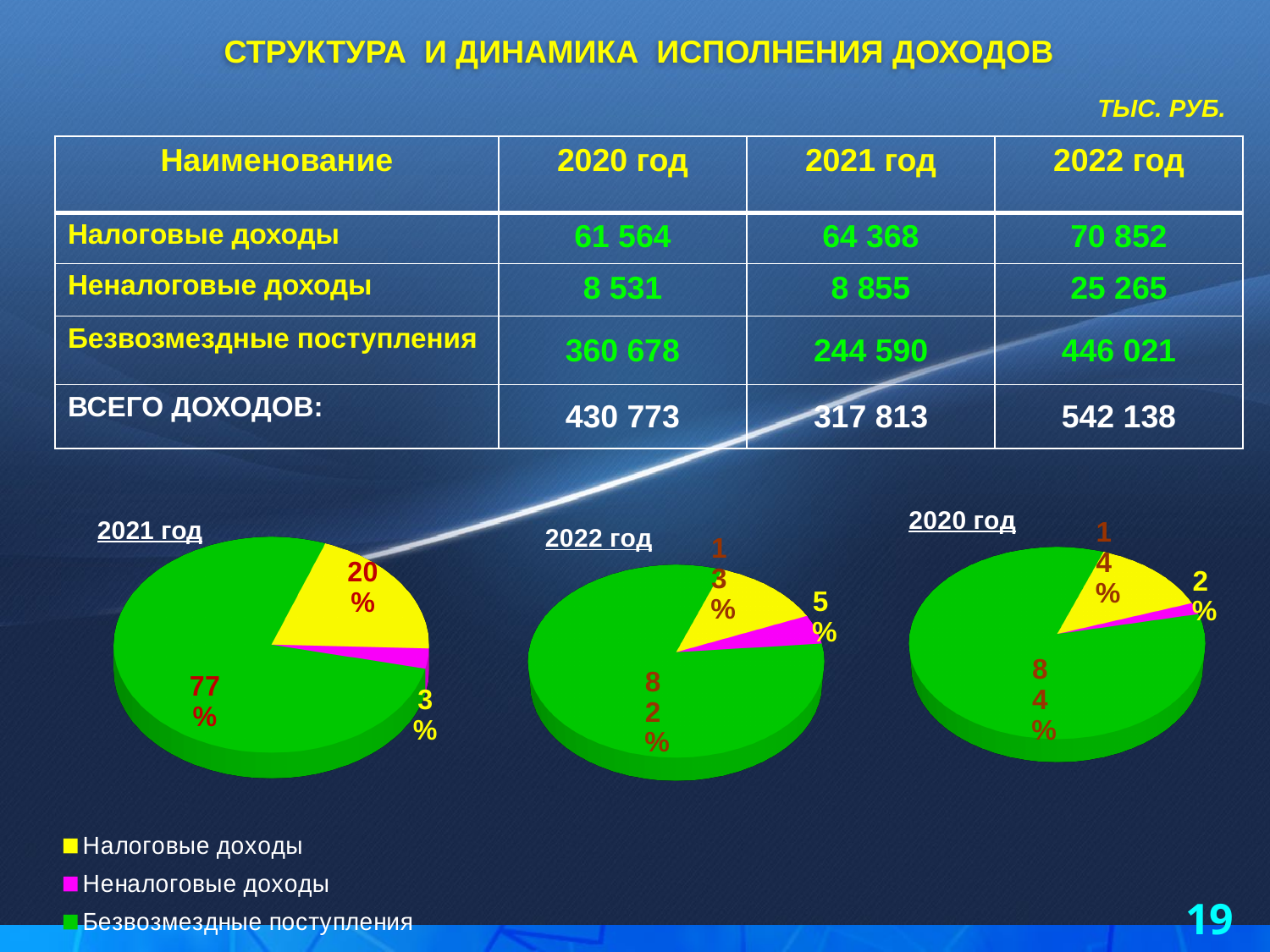
In the 2021 год pie chart, what is the difference in percentage points between Безвозмездные поступления and Налоговые доходы? 57% In the 2020 год pie chart, what share is shown for Безвозмездные поступления? 84% In the 2022 год pie chart, what share is shown for Налоговые доходы? 13% In the 2021 год pie chart, what share is shown for Налоговые доходы? 20% Is the share of Налоговые доходы larger in the 2021 год pie chart or the 2022 год pie chart? 2021 год In the 2020 год pie chart, which category has the smallest slice? Неналоговые доходы In the 2021 год pie chart, what share is shown for Безвозмездные поступления? 77% In the 2022 год pie chart, which category has the largest slice? Безвозмездные поступления In the 2022 год pie chart, what share is shown for Неналоговые доходы? 5% How many categories does the legend below the pie charts list? 3 How many slices does the 2022 год pie chart have? 3 What type of chart is used for the 2020 год chart? Pie chart